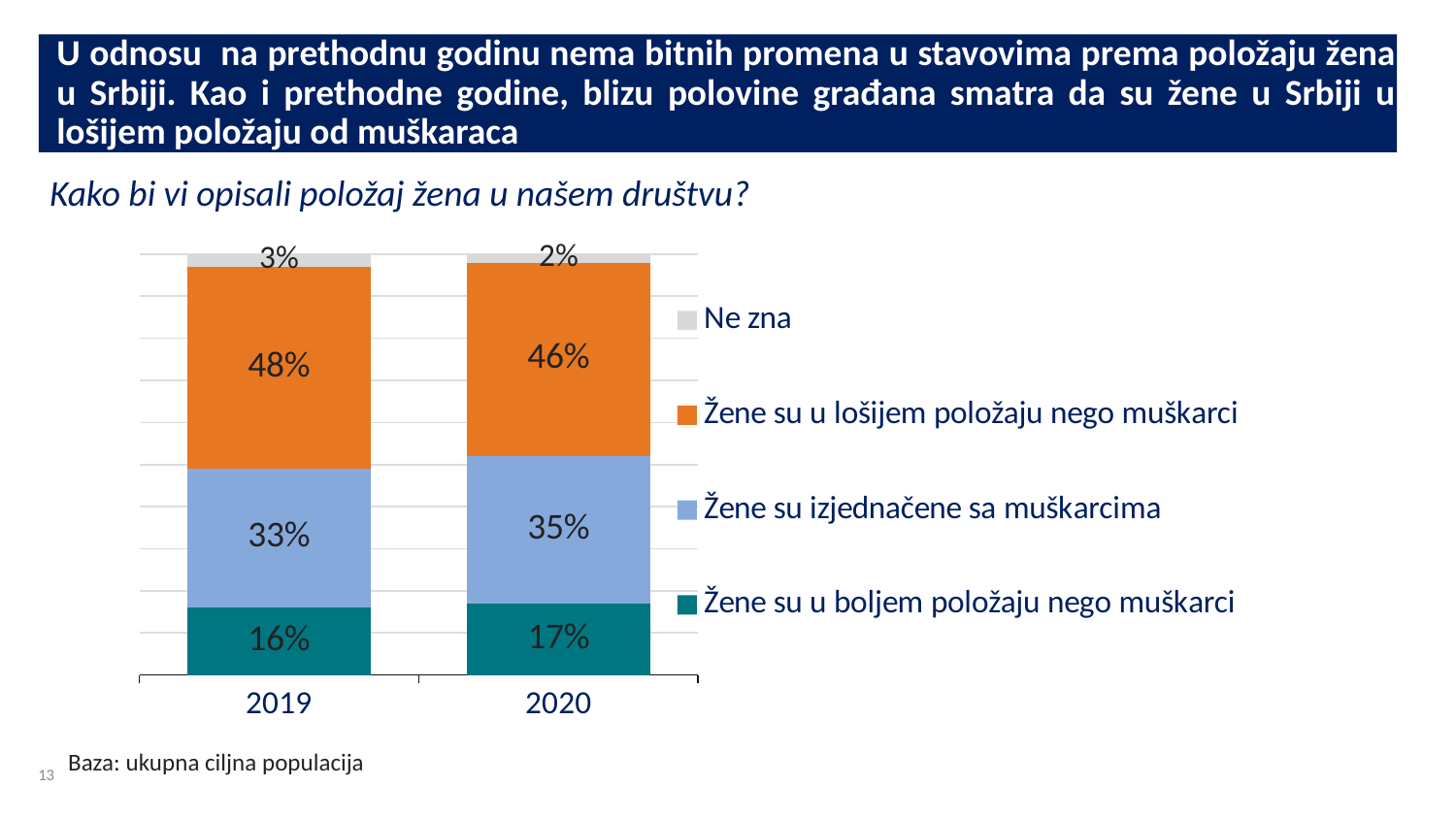
How many years (categories) are shown on the x axis? 2 Which response category has the lowest value in 2019? Ne zna What is the 'Ne zna' value for 2019? 3% What percentage of respondents in 2019 said 'Žene su u lošijem položaju nego muškarci'? 48% What percentage of respondents in 2020 said 'Žene su izjednačene sa muškarcima'? 35% What is the value for 'Žene su u boljem položaju nego muškarci' in 2020? 17% Which year has the larger value for 'Žene su izjednačene sa muškarcima', 2019 or 2020? 2020 What is the total of the stacked bar for 2019? 100% What kind of chart is shown on the slide? Stacked bar chart How many series does the legend list? 4 Which response category has the highest value in 2020? Žene su u lošijem položaju nego muškarci What is the difference between the 2019 and 2020 values for 'Žene su u lošijem položaju nego muškarci'? 2 percentage points